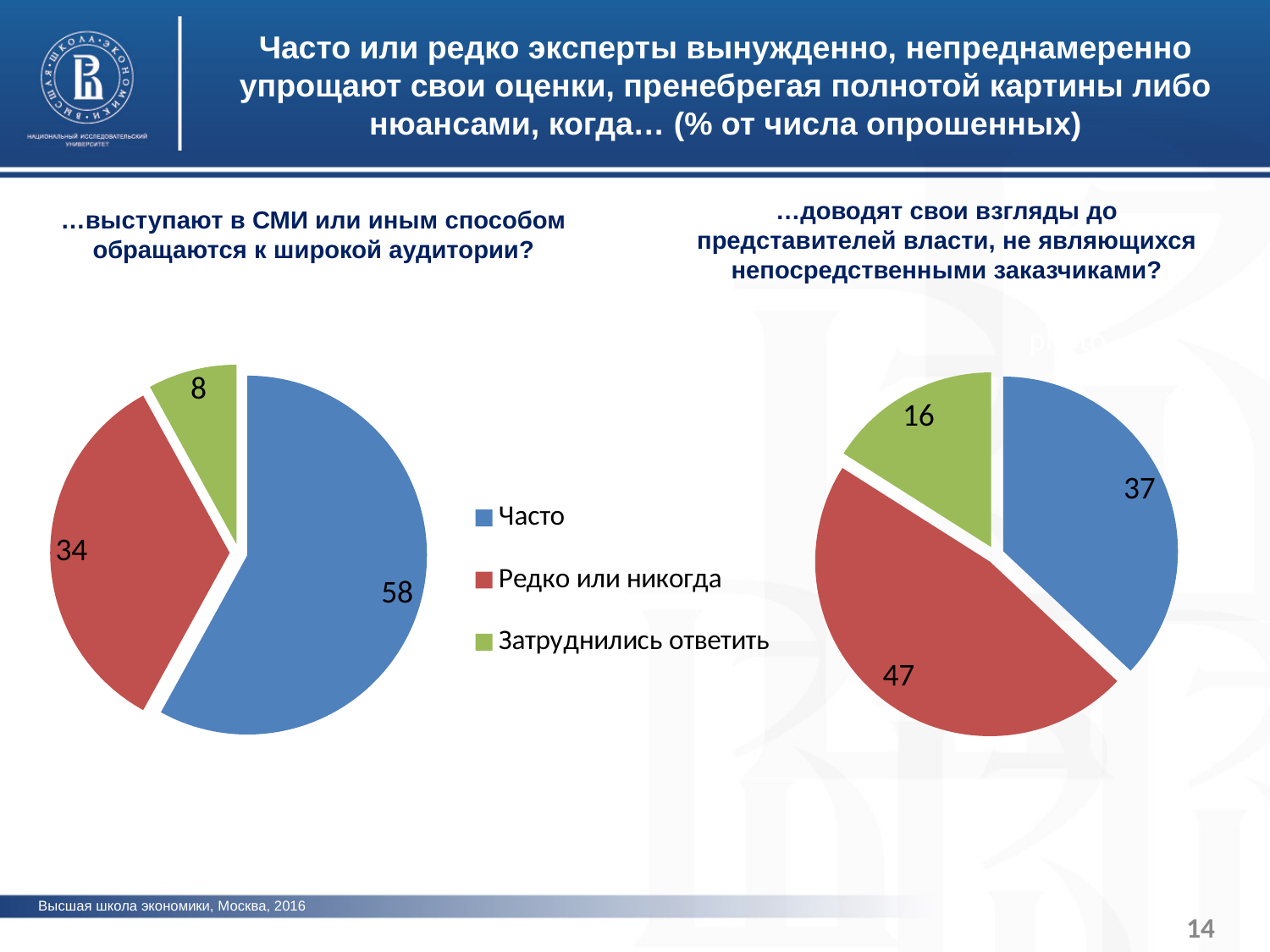
In the left pie chart (…выступают в СМИ…), which category has the largest slice? Часто What type of chart is used on this slide? Pie chart In the left pie chart (…выступают в СМИ…), what is the value for «Затруднились ответить»? 8 In the right pie chart (…доводят свои взгляды до представителей власти…), which is larger: «Часто» or «Редко или никогда»? Редко или никогда In the left pie chart (…выступают в СМИ…), what is the value for «Редко или никогда»? 34 In the right pie chart (…доводят свои взгляды до представителей власти…), which category has the smallest slice? Затруднились ответить In the left pie chart (…выступают в СМИ или иным способом обращаются к широкой аудитории?), what is the value for «Часто»? 58 In the right pie chart (…доводят свои взгляды до представителей власти…), what is the value for «Затруднились ответить»? 16 How many categories does the legend list? 3 In the right pie chart (…доводят свои взгляды до представителей власти…), what is the value for «Часто»? 37 In the right pie chart (…доводят свои взгляды до представителей власти…), what is the value for «Редко или никогда»? 47 In the left pie chart (…выступают в СМИ…), what is the difference between the values for «Часто» and «Редко или никогда»? 24